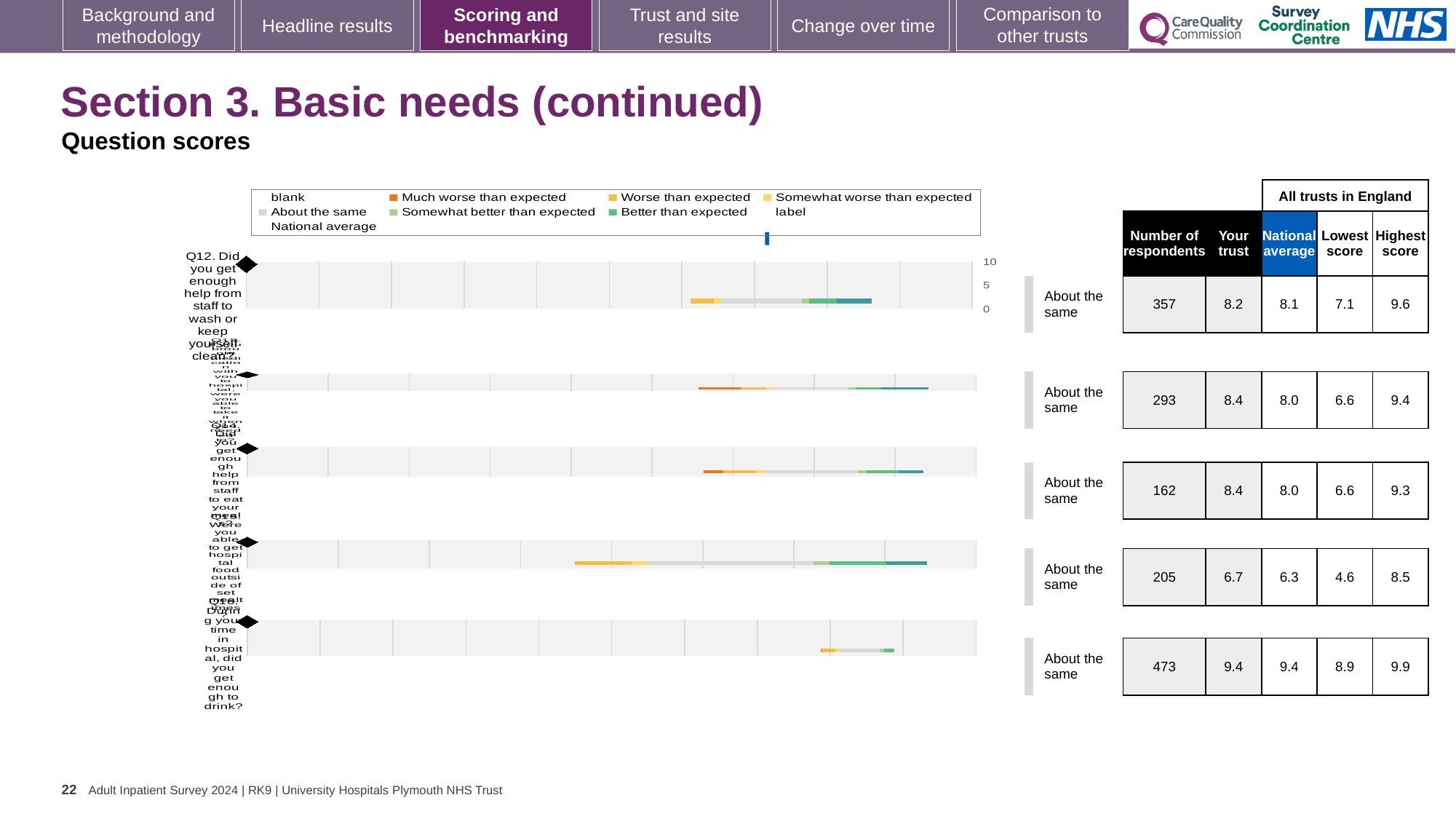
What is the difference between the 'Your trust' score and the national average for Q12? 0.1 What benchmark category is shown for every question row on the slide? About the same How many respondents are listed for Q12 (help from staff to wash or keep yourself clean)? 357 Which colour in the legend represents 'Much worse than expected'? orange What is the 'Your trust' score for Q12 (help from staff to wash or keep yourself clean)? 8.2 What kind of chart is shown on the slide? bar chart What is the maximum value shown on the chart's score axis? 10 What is the national average score for Q12 (help from staff to wash or keep yourself clean)? 8.1 Which is larger for Q12: the 'Your trust' score or the national average? Your trust How many question rows (bars) are plotted in the chart? 5 What is the highest score among all trusts in England for Q12? 9.6 Which row has the lowest 'Your trust' score? the fourth row (6.7)